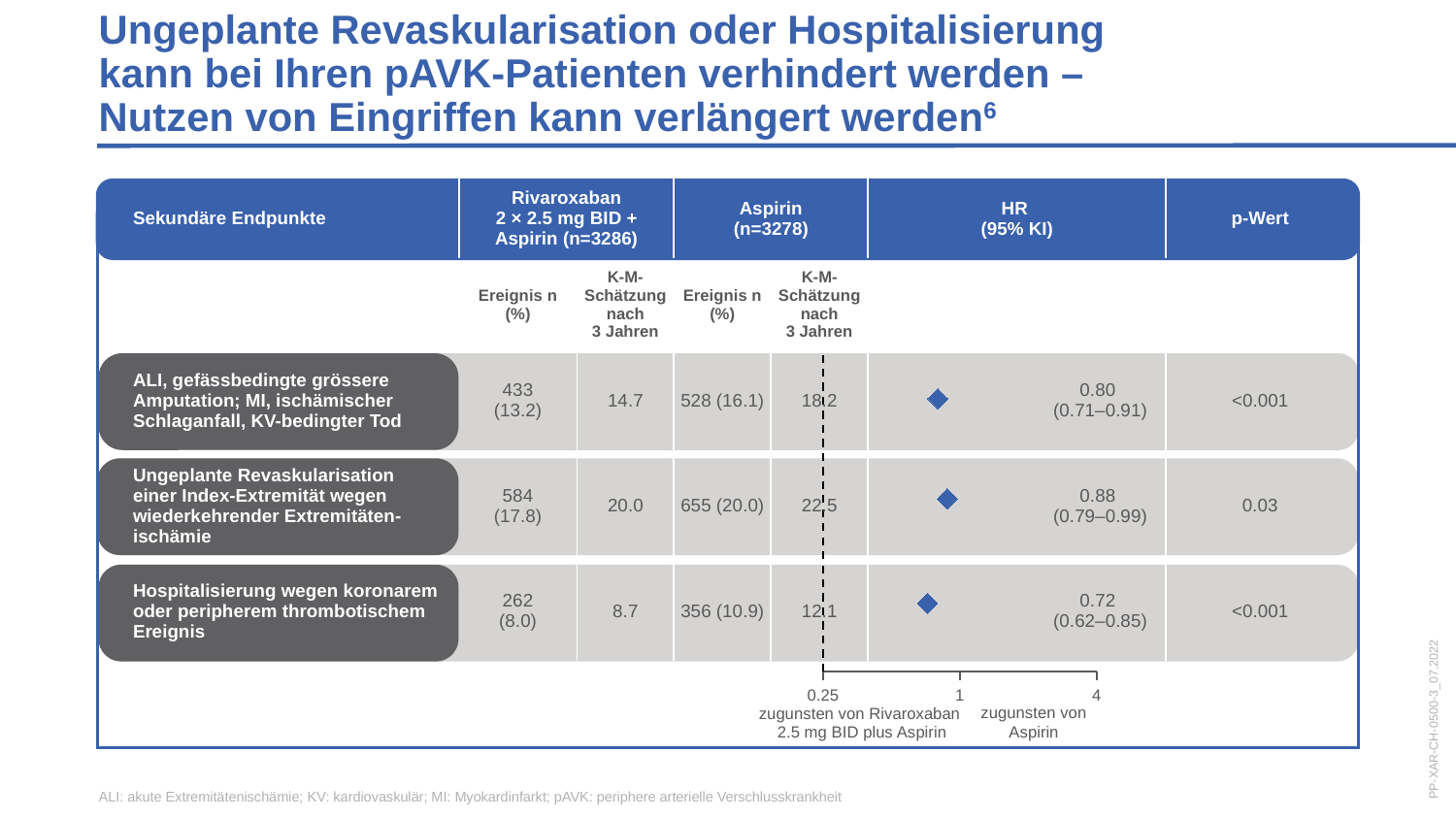
What is the HR (hazard ratio) for the endpoint 'ALI, gefässbedingte grössere Amputation; MI, ischämischer Schlaganfall, KV-bedingter Tod'? 0.80 Is the HR for 'ALI, gefässbedingte grössere Amputation; MI, ischämischer Schlaganfall, KV-bedingter Tod' greater or less than 1? less What is the HR for the endpoint 'Ungeplante Revaskularisation einer Index-Extremität wegen wiederkehrender Extremitätenischämie'? 0.88 What is the difference between the HR for 'Ungeplante Revaskularisation' and the HR for 'Hospitalisierung wegen koronarem oder peripherem thrombotischem Ereignis'? 0.16 How many secondary endpoints are plotted in the forest plot? 3 What is the p-Wert for the endpoint 'Ungeplante Revaskularisation einer Index-Extremität wegen wiederkehrender Extremitätenischämie'? 0.03 What kind of chart is shown in the HR (95% KI) column? forest plot Which secondary endpoint has the lowest HR? Hospitalisierung wegen koronarem oder peripherem thrombotischem Ereignis According to the axis labels, which side of the forest plot (left or right of 1) favours Rivaroxaban 2.5 mg BID plus Aspirin? left For the endpoint 'ALI, gefässbedingte grössere Amputation; MI, ischämischer Schlaganfall, KV-bedingter Tod', which group has the larger K-M Schätzung nach 3 Jahren: Rivaroxaban 2 × 2.5 mg BID + Aspirin or Aspirin? Aspirin Which secondary endpoint has the highest HR? Ungeplante Revaskularisation einer Index-Extremität wegen wiederkehrender Extremitätenischämie What is the 95% KI for the endpoint 'Hospitalisierung wegen koronarem oder peripherem thrombotischem Ereignis'? 0.62–0.85